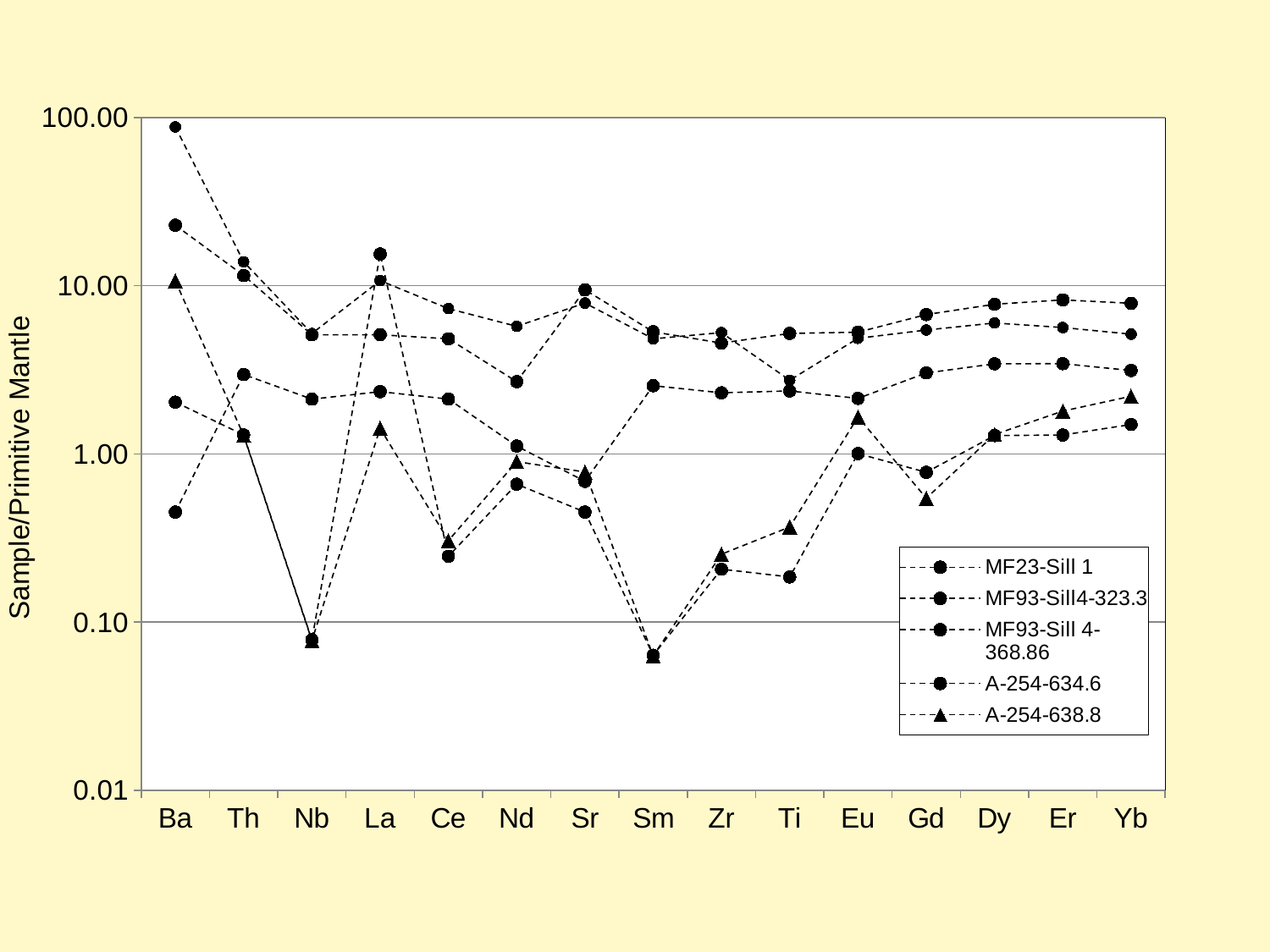
What kind of chart is shown on the slide? line chart Is the value for A-254-638.8 at Sm greater or less than 0.10? less Is the value for A-254-638.8 at Eu greater or less than 1.00? greater Which series is plotted with triangle markers? A-254-638.8 Is the value for A-254-638.8 at Nb greater or less than 0.10? less How many elements are shown along the x axis? 15 What is the label of the y axis? Sample/Primitive Mantle At which element does the highest plotted value on the chart occur? Ba For the A-254-638.8 series, which is larger, the value at Yb or the value at Gd? Yb How many series does the legend list? 5